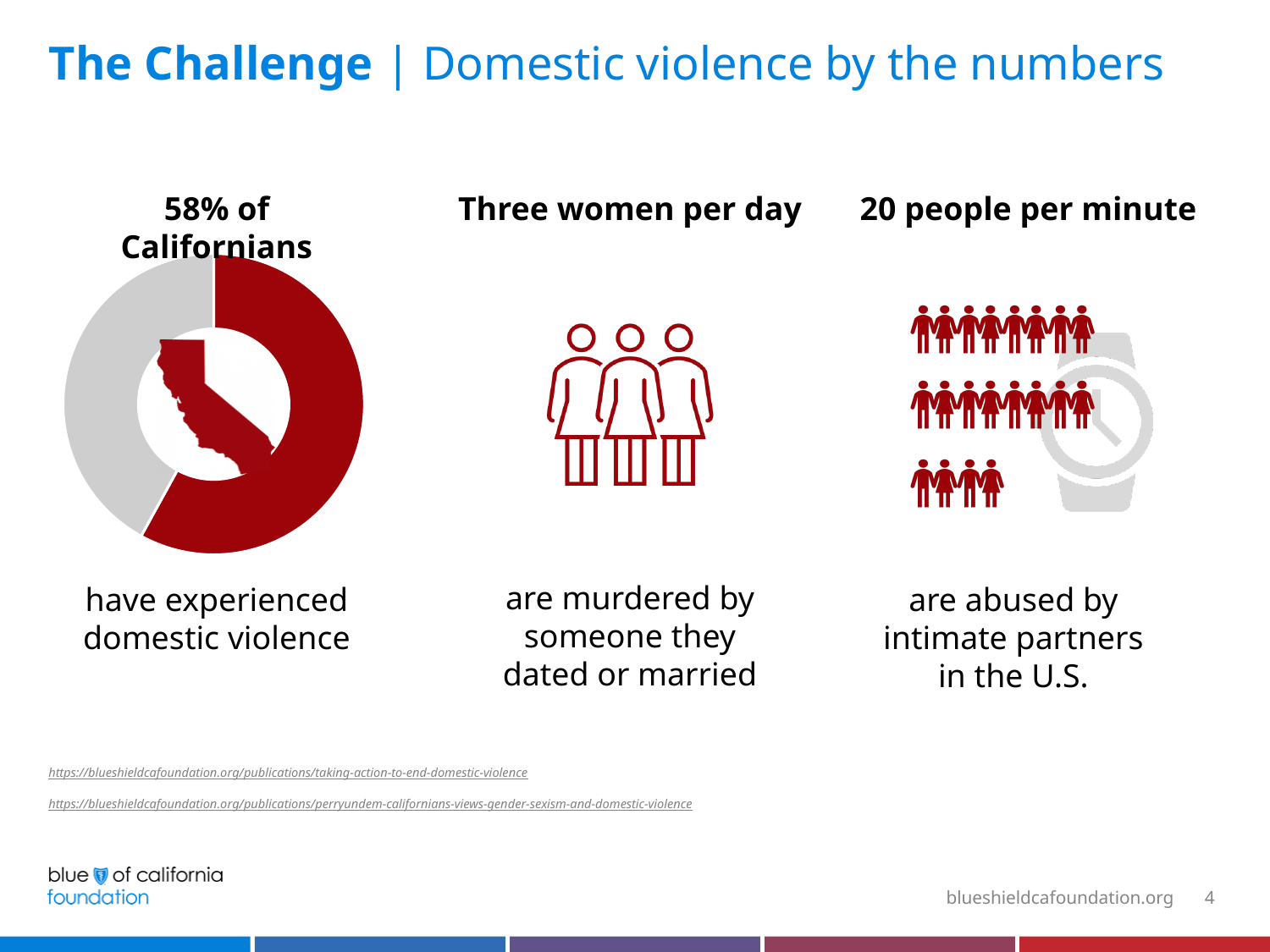
What colour is the slice representing the 58% of Californians who have experienced domestic violence? red According to the chart, what percentage of Californians have experienced domestic violence? 58% How many slices does the donut chart have? 2 Is the gray slice of the donut chart greater or less than 50%? less Which slice of the donut chart is larger, the red one or the gray one? red What kind of chart is shown under the heading '58% of Californians'? pie chart (donut) What share of the donut chart does the gray slice represent? 42% What image appears in the centre of the donut chart? an outline of California Is the red slice of the donut chart greater or less than 50%? greater